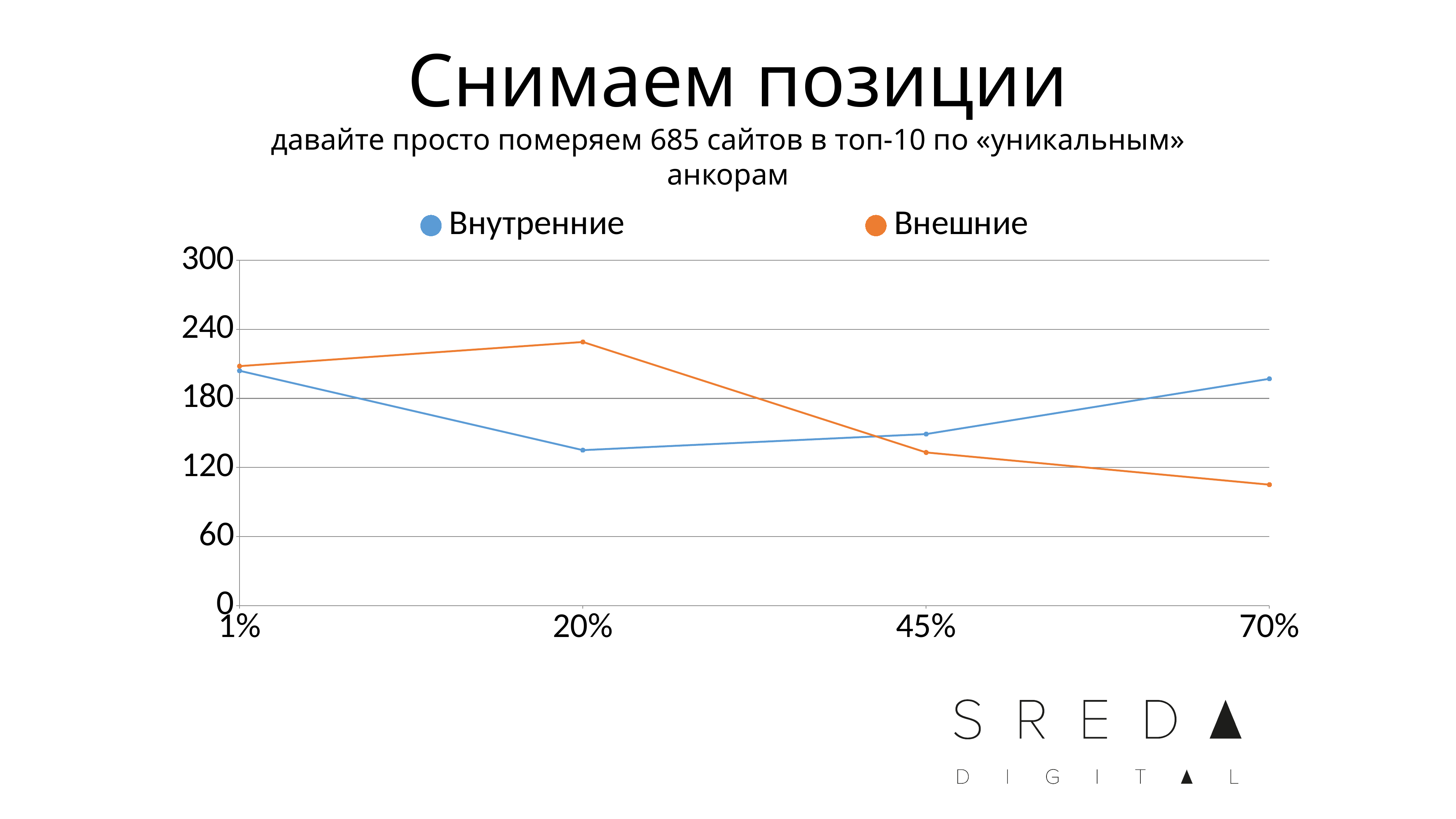
At 70%, which series has the larger value, Внутренние or Внешние? Внутренние Does the Внешние series rise or fall from 20% to 70%? fall Is the value for Внешние at 20% greater or less than 180? greater At which x-axis category does the Внутренние series reach its lowest value? 20% Is the value for Внешние at 70% greater or less than 120? less At 20%, which series has the larger value, Внутренние or Внешние? Внешние How many categories are shown on the x axis? 4 How many series does the legend list? 2 What kind of chart is shown on the slide? line chart Which colour is used for the Внешние series? orange At which x-axis category does the Внешние series reach its lowest value? 70% At which x-axis category does the Внешние series reach its highest value? 20%